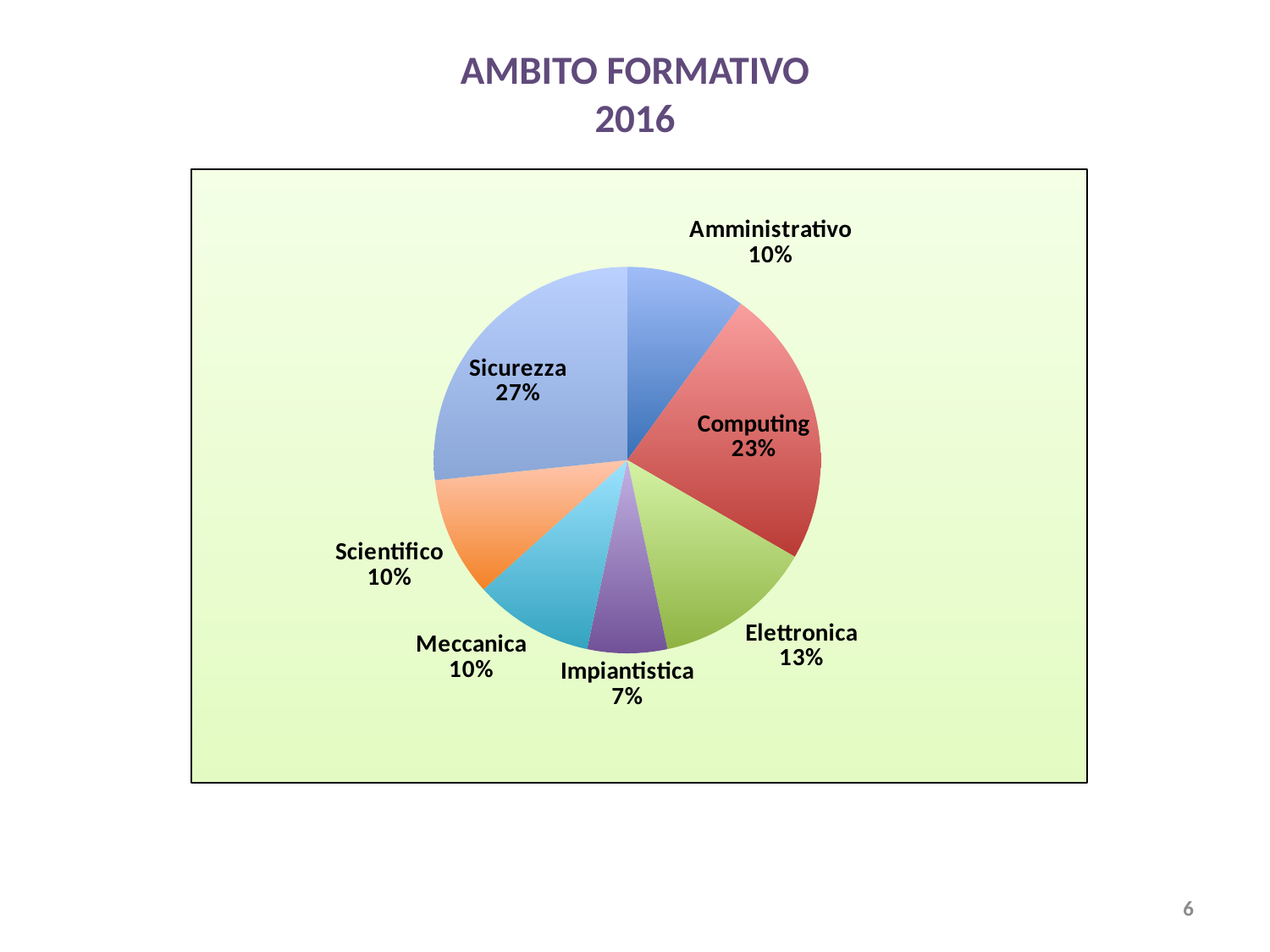
How many slices does the pie chart have? 7 What kind of chart is shown on the slide? pie chart Which category has the smallest slice of the pie? Impiantistica What share of the pie does Computing have? 23% What is the title shown above the chart? AMBITO FORMATIVO 2016 What share of the pie does Elettronica have? 13% What share of the pie does Sicurezza have? 27% What is the difference in percentage points between Sicurezza and Computing? 4 Which category has the largest slice of the pie? Sicurezza What is the difference in percentage points between Computing and Impiantistica? 16 Which is larger, the share for Elettronica or the share for Meccanica? Elettronica